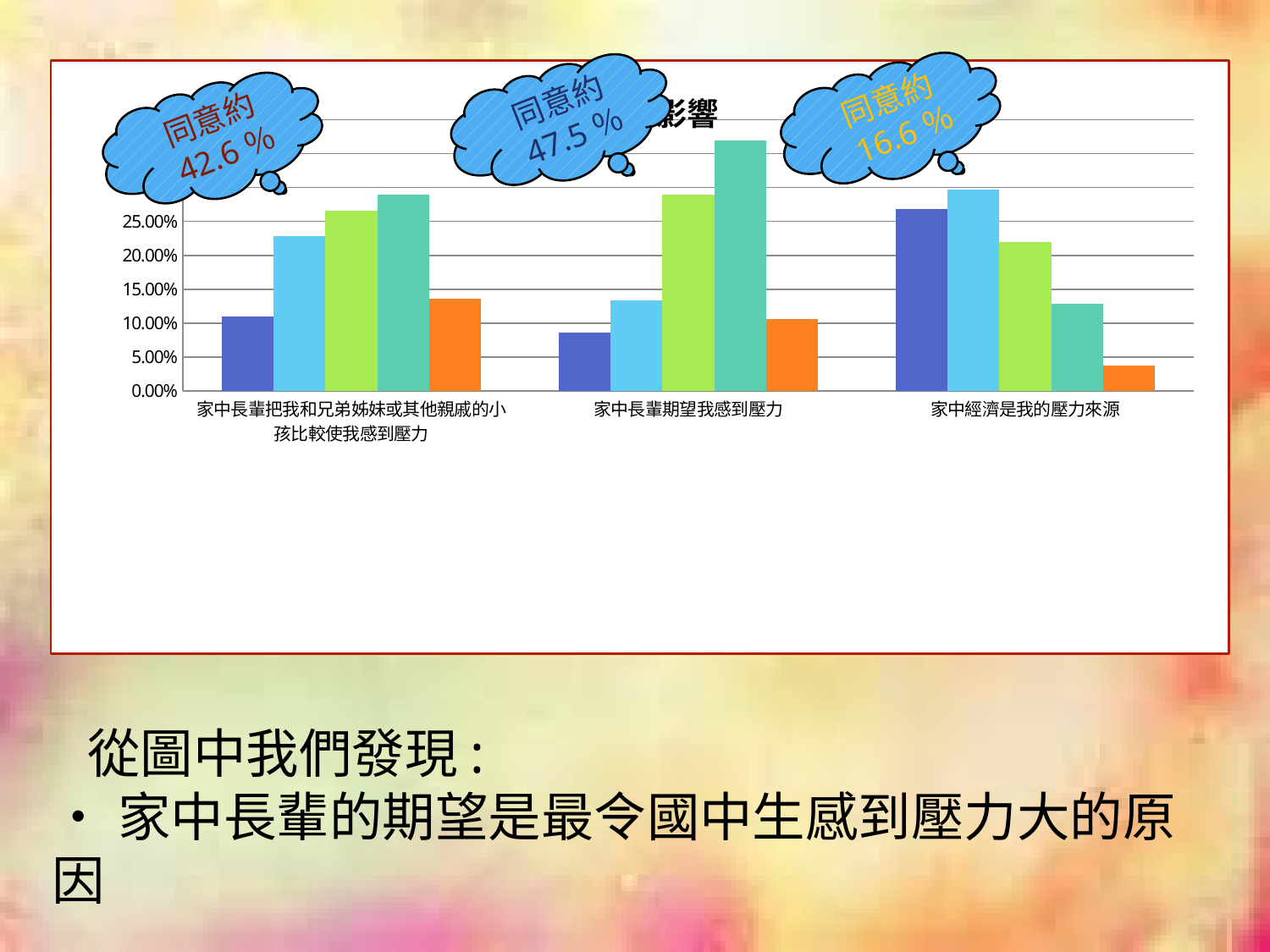
Which is larger: the orange bar for 家中長輩把我和兄弟姊妹或其他親戚的小孩比較使我感到壓力 or the orange bar for 家中經濟是我的壓力來源? 家中長輩把我和兄弟姊妹或其他親戚的小孩比較使我感到壓力 According to the thought bubble above 家中長輩期望我感到壓力, approximately what percentage agreed? 47.5 % Which is larger: the teal bar for 家中長輩期望我感到壓力 or the teal bar for 家中經濟是我的壓力來源? 家中長輩期望我感到壓力 How many bars are plotted for each category in the chart? 5 Is the teal bar for 家中長輩期望我感到壓力 greater or less than 25.00%? greater Is the orange bar for 家中經濟是我的壓力來源 greater or less than 5.00%? less Is the dark blue bar for 家中經濟是我的壓力來源 greater or less than 25.00%? greater Which category contains the shortest bar in the chart? 家中經濟是我的壓力來源 What kind of chart is shown on the slide? bar chart Which category contains the tallest bar in the chart? 家中長輩期望我感到壓力 How many categories are shown along the x axis of the chart? 3